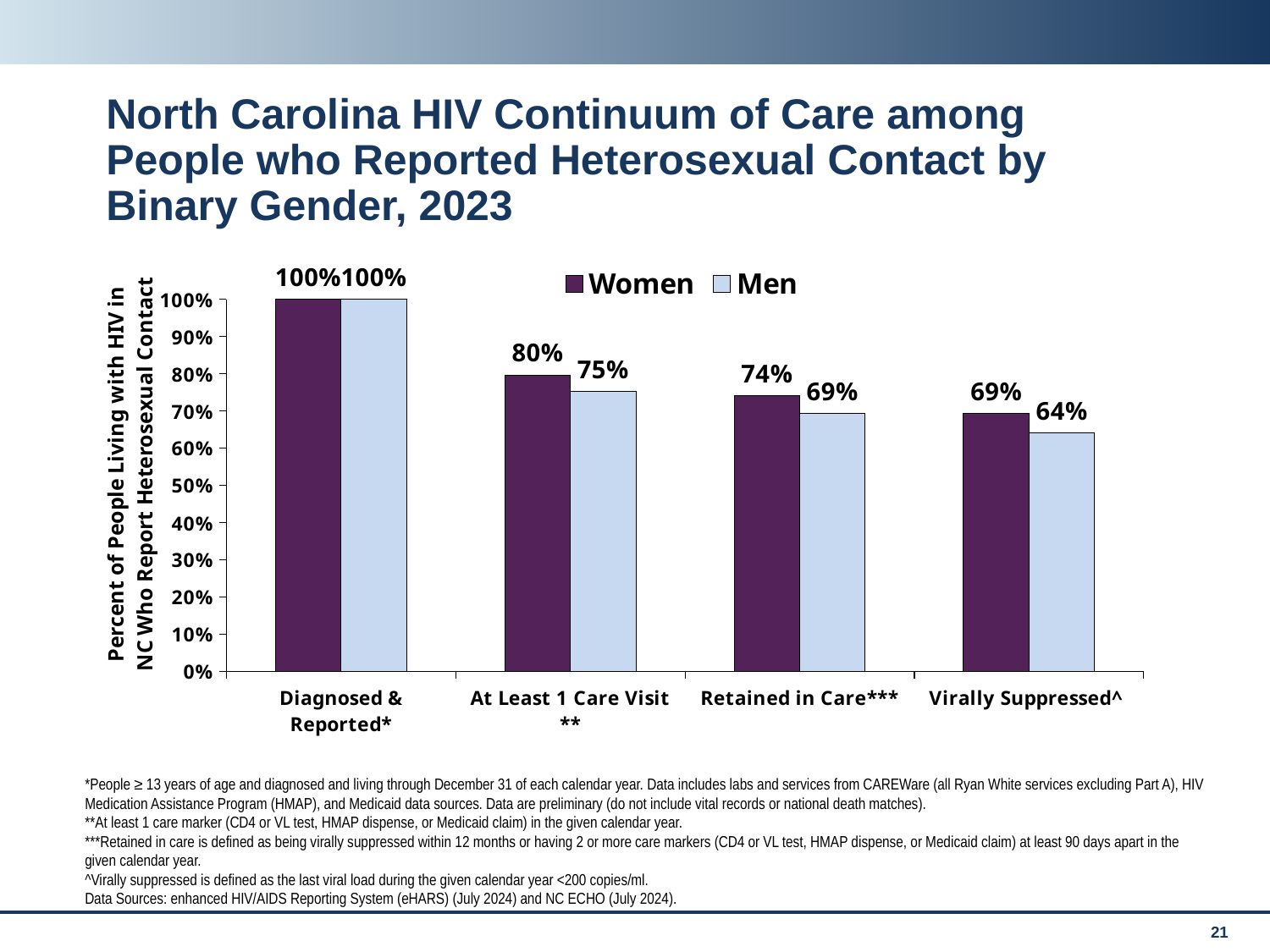
How many series does the legend list? 2 What is the difference between Women and Men in the At Least 1 Care Visit category? 5% How many categories are shown on the x axis? 4 Which category has the highest value for Men? Diagnosed & Reported What kind of chart is shown on the slide? Bar chart What is the value for Men in the Virally Suppressed category? 64% Do the values for Men rise or fall from left to right across the categories? Fall Which category has the lowest value for Women? Virally Suppressed What is the difference between Women and Men in the Retained in Care category? 5% What is the value for Men in the Retained in Care category? 69% Which is larger, the value for Women or for Men in the Virally Suppressed category? Women What is the value for Women in the At Least 1 Care Visit category? 80%